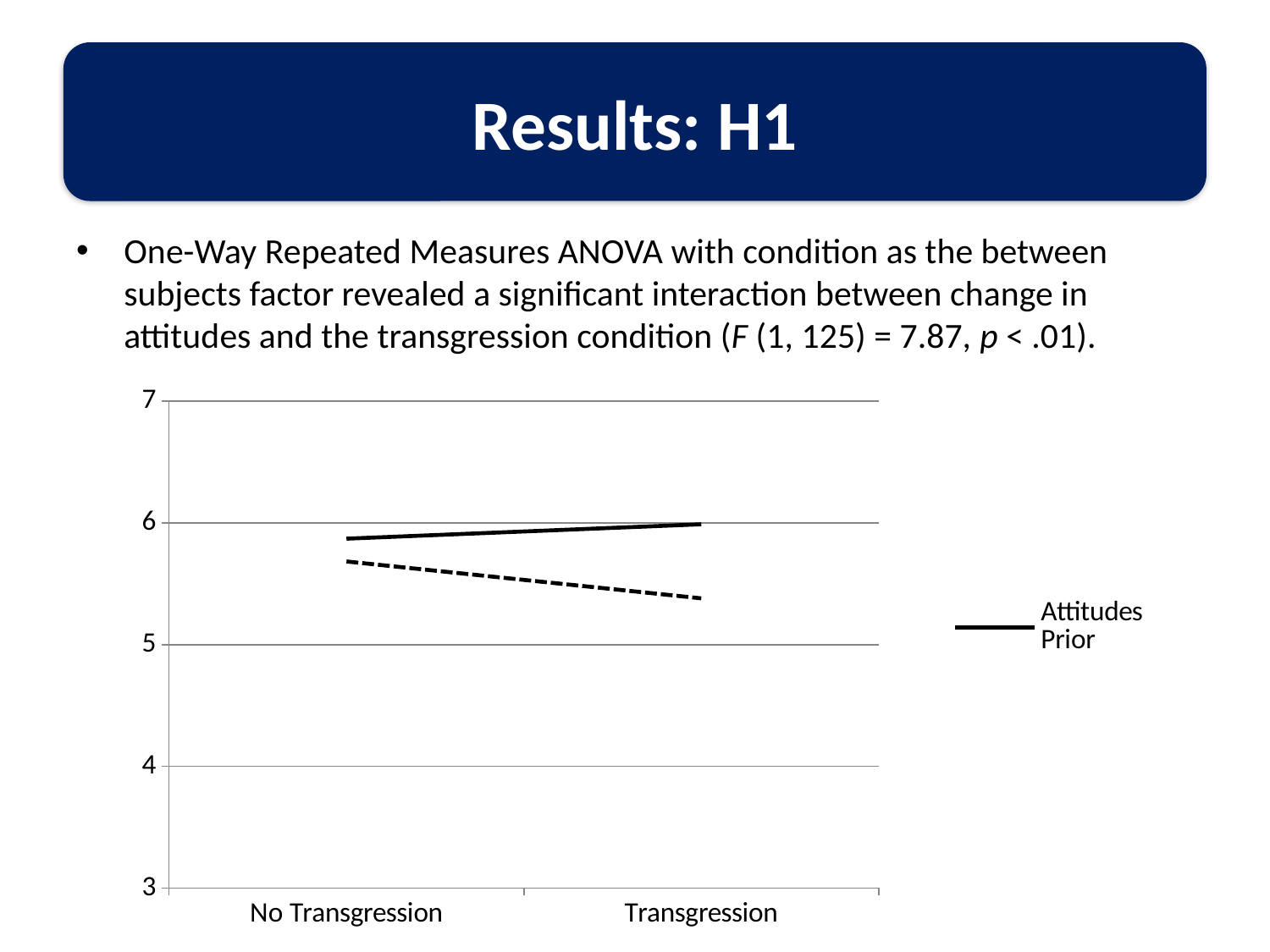
Does the Attitudes Prior line rise or fall from No Transgression to Transgression? rise At Transgression, which line is higher: the solid Attitudes Prior line or the dashed line? the solid Attitudes Prior line How many categories are shown on the x axis of the chart? 2 Is the value of the Attitudes Prior line at No Transgression greater or less than 5? greater What kind of chart is shown on the slide? line chart What is the highest value shown on the chart's y axis? 7 Is the value of the dashed line at No Transgression greater or less than 5? greater How many series does the chart's legend list? 1 Is the value of the dashed line at Transgression greater or less than 6? less Does the dashed line rise or fall from No Transgression to Transgression? fall What is the name of the series listed in the chart's legend? Attitudes Prior